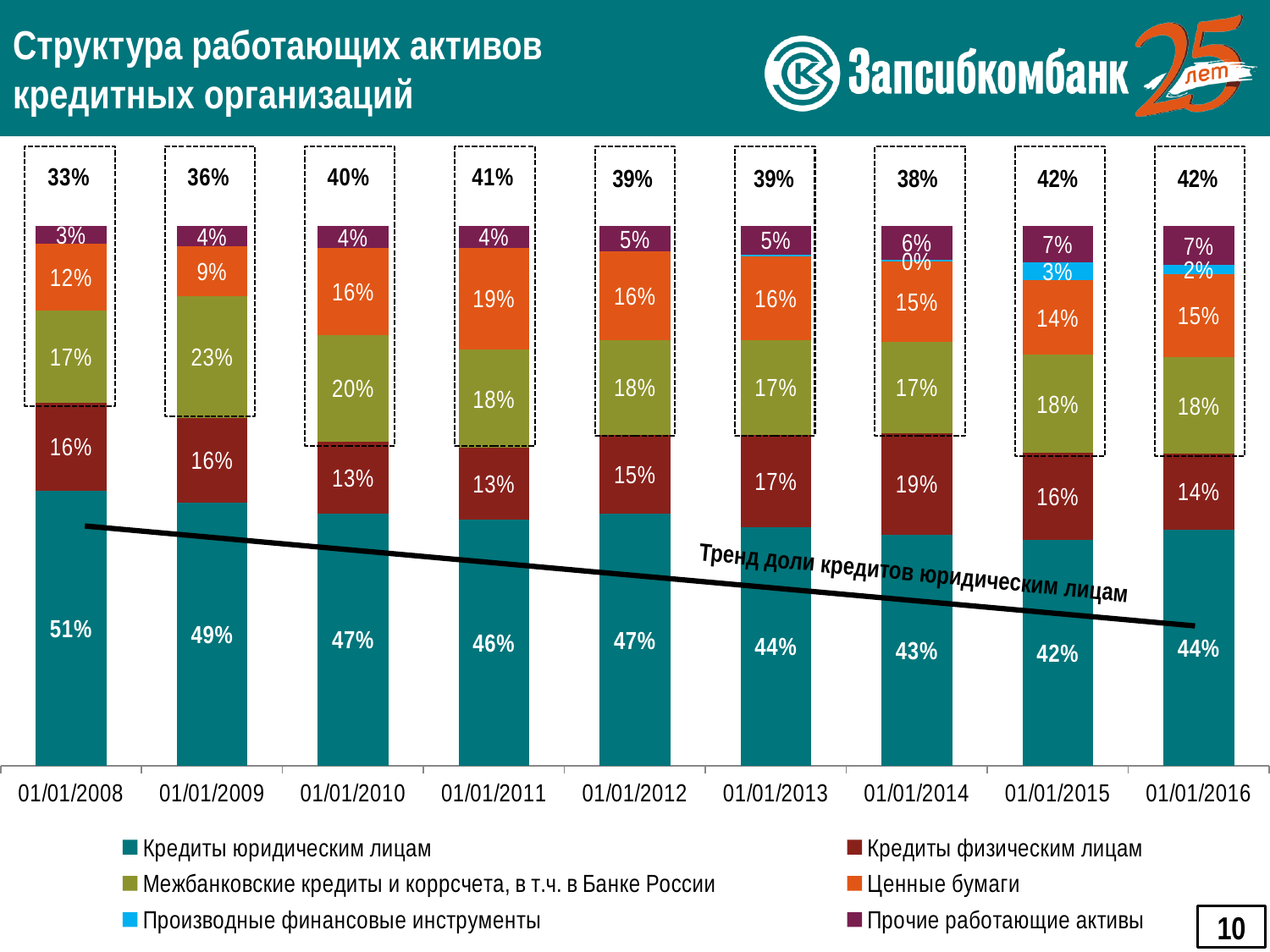
What is the difference between the Кредиты физическим лицам values on 01/01/2014 and 01/01/2016? 5% Does the share of Кредиты юридическим лицам generally rise or fall from 01/01/2008 to 01/01/2016? Fall What is the value for Кредиты юридическим лицам on 01/01/2008? 51% What kind of chart is shown on the slide? Stacked bar chart What is the value for Производные финансовые инструменты on 01/01/2015? 3% On which date is the share of Кредиты юридическим лицам the highest? 01/01/2008 On which date is the share of Кредиты юридическим лицам the lowest? 01/01/2015 What is the value for Ценные бумаги on 01/01/2011? 19% What is the value for Межбанковские кредиты и коррсчета, в т.ч. в Банке России on 01/01/2009? 23% How many dates are shown on the x axis? 9 Which is larger on 01/01/2010: Кредиты физическим лицам or Межбанковские кредиты и коррсчета, в т.ч. в Банке России? Межбанковские кредиты и коррсчета, в т.ч. в Банке России How many series does the legend list? 6